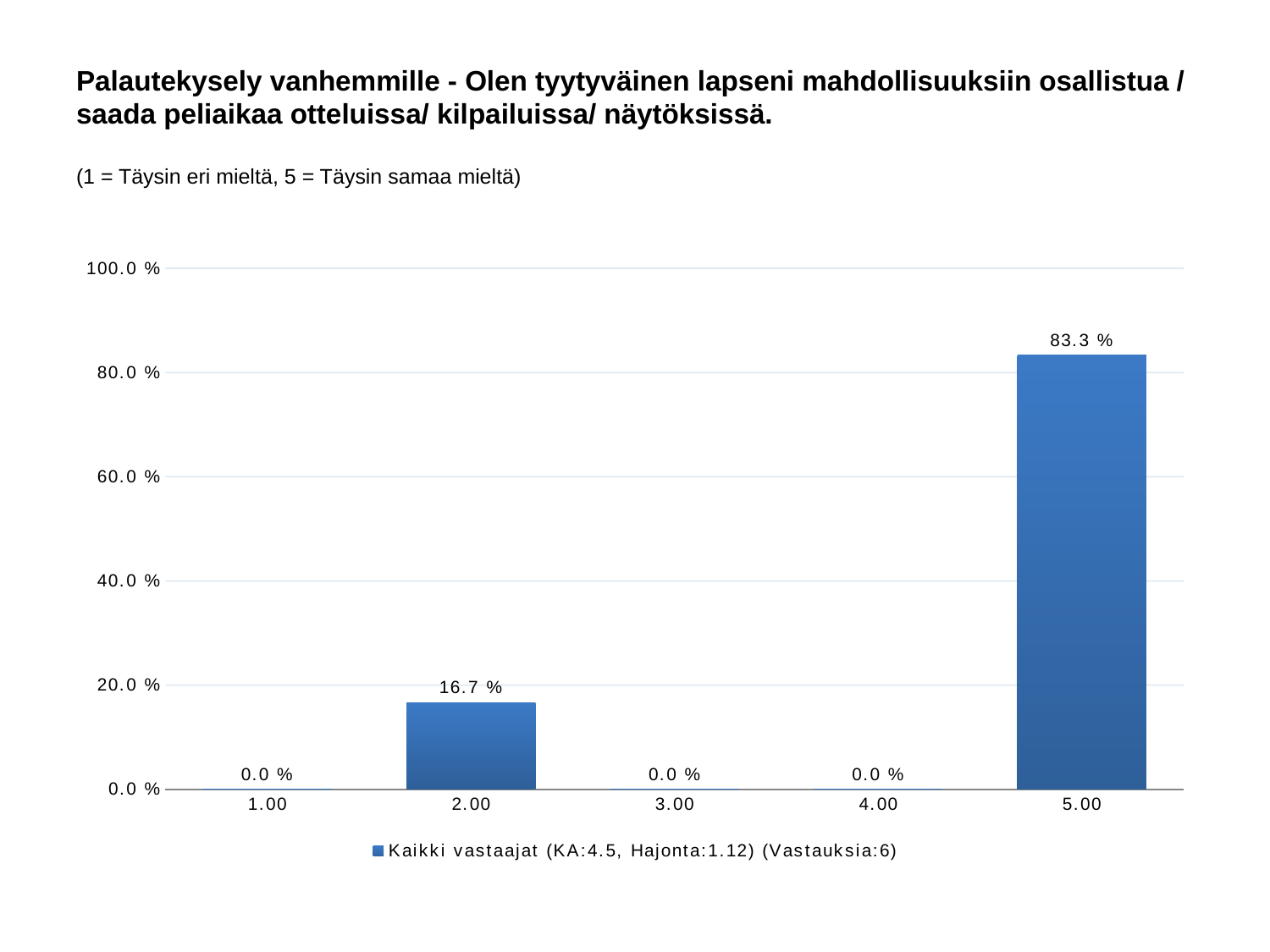
What is the value for category 2.00? 16.7 % Which is larger, the value for 2.00 or the value for 5.00? 5.00 What is the difference between the values for 5.00 and 2.00? 66.6 % What is the value for category 5.00? 83.3 % How many series does the legend list? 1 Which category has the highest value? 5.00 What kind of chart is shown? bar chart Is the value for 5.00 greater or less than 80.0 %? greater What is the legend entry for the series? Kaikki vastaajat (KA:4.5, Hajonta:1.12) (Vastauksia:6) What is the value for category 4.00? 0.0 % What is the value for category 1.00? 0.0 % How many categories are shown on the x axis? 5